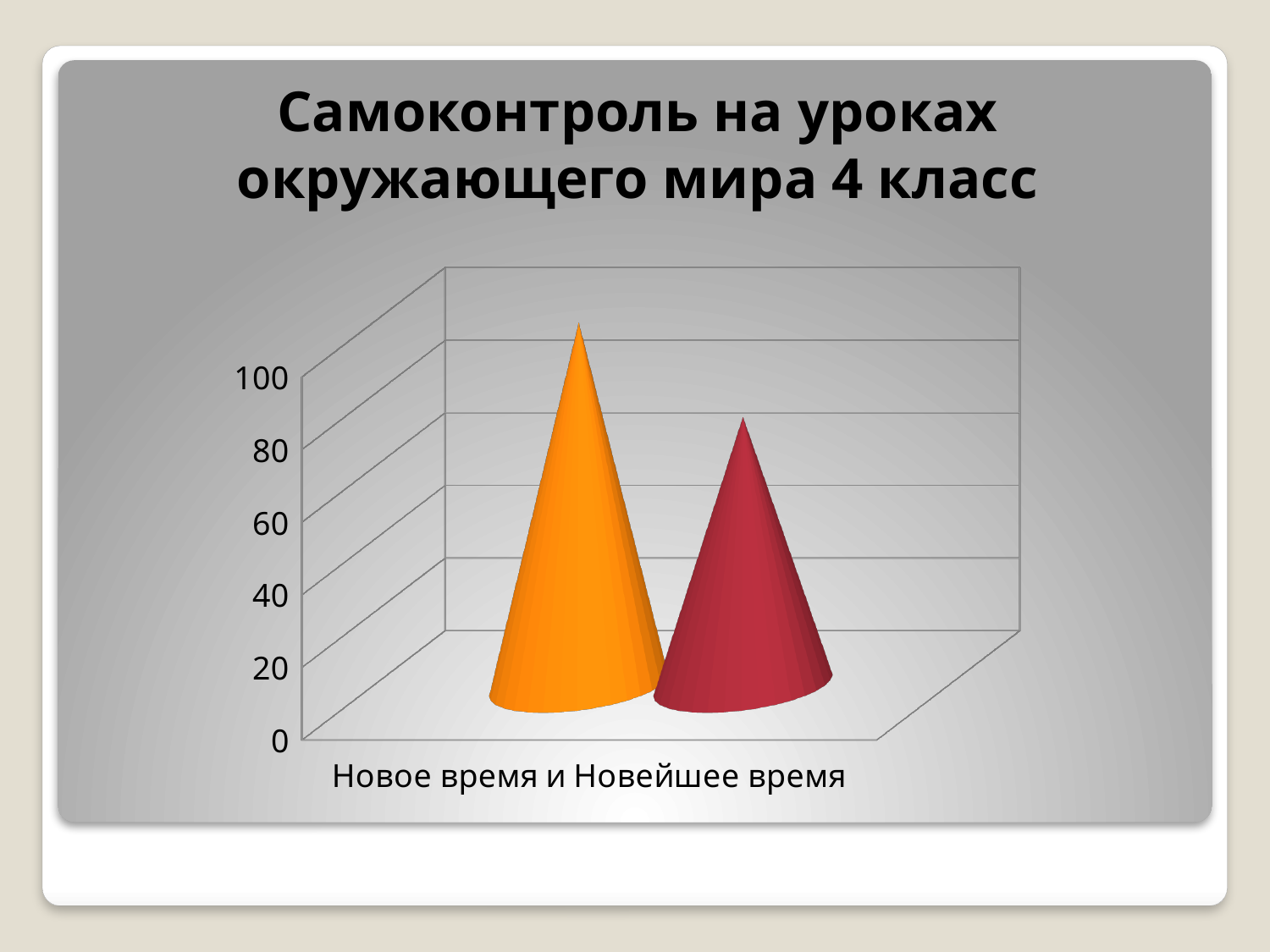
Is the value of the red bar greater or less than 60? greater Which bar is taller, the orange one or the red one? the orange one Which bar has the lowest value in the chart? the red bar Is the value of the red bar greater or less than 100? less What is the highest tick value shown on the vertical axis? 100 Is the value of the orange bar greater or less than 40? greater What kind of chart is shown on the slide? bar chart How many bars are plotted in the chart? 2 What is the category label shown on the horizontal axis? Новое время и Новейшее время What is the title of the slide containing the chart? Самоконтроль на уроках окружающего мира 4 класс Which bar has the highest value in the chart? the orange bar